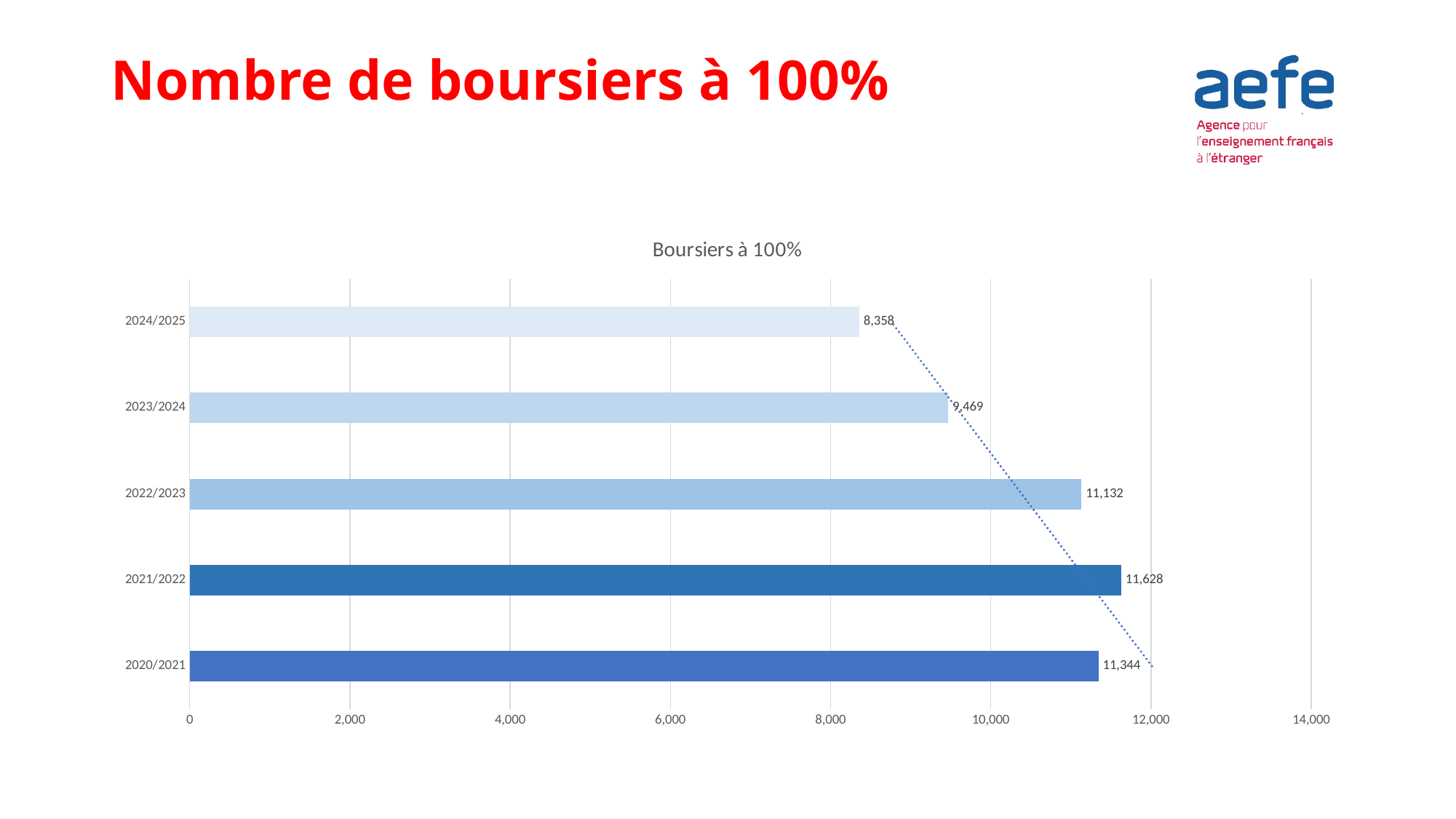
Which school year has the lowest number of boursiers à 100%? 2024/2025 Which is larger, the value for 2020/2021 or the value for 2022/2023? 2020/2021 What kind of chart is shown on the slide? bar chart What is the value for 2020/2021? 11,344 What is the title of the chart? Boursiers à 100% Is the value for 2023/2024 greater or less than 10,000? less What is the difference between the values for 2021/2022 and 2024/2025? 3,270 What is the value for 2024/2025? 8,358 How many school years are shown in the chart? 5 Which school year has the highest number of boursiers à 100%? 2021/2022 What is the difference between the values for 2022/2023 and 2023/2024? 1,663 What is the value for 2021/2022? 11,628